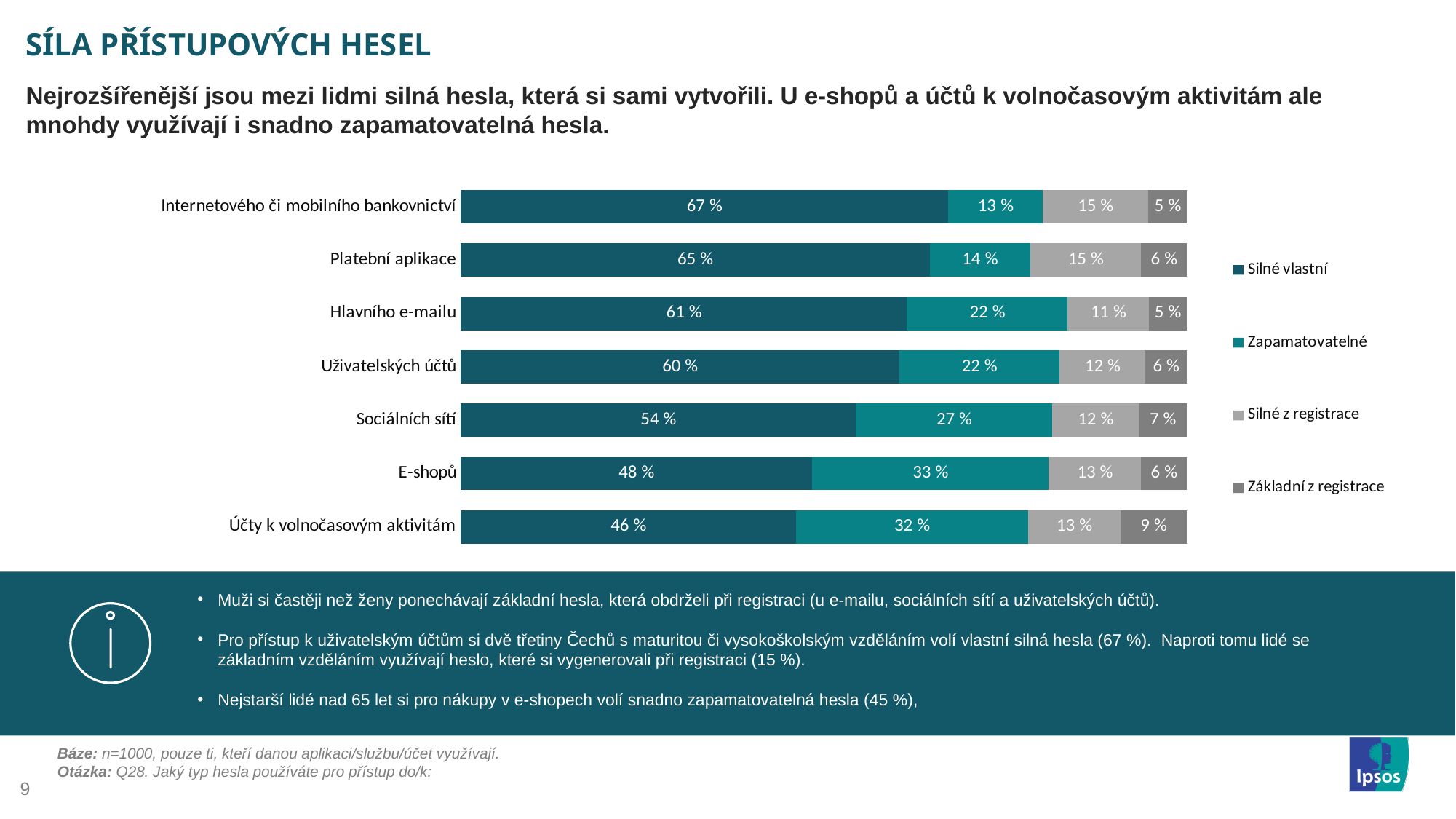
How many categories are shown on the chart? 7 Which is larger: the 'Zapamatovatelné' value for 'Sociálních sítí' or for 'Uživatelských účtů'? Sociálních sítí What is the value of 'Silné vlastní' for 'Internetového či mobilního bankovnictví'? 67 % What is the value of 'Silné z registrace' for 'Hlavního e-mailu'? 11 % Which category has the highest value for 'Silné vlastní'? Internetového či mobilního bankovnictví What is the value of 'Zapamatovatelné' for 'E-shopů'? 33 % How many series does the legend list? 4 What is the difference between the 'Silné vlastní' values for 'Platební aplikace' and 'Sociálních sítí'? 11 % Which category has the lowest value for 'Zapamatovatelné'? Internetového či mobilního bankovnictví What type of chart is shown on the slide? Stacked bar chart What is the value of 'Základní z registrace' for 'Účty k volnočasovým aktivitám'? 9 % What is the total of the stacked bar for 'Účty k volnočasovým aktivitám'? 100 %